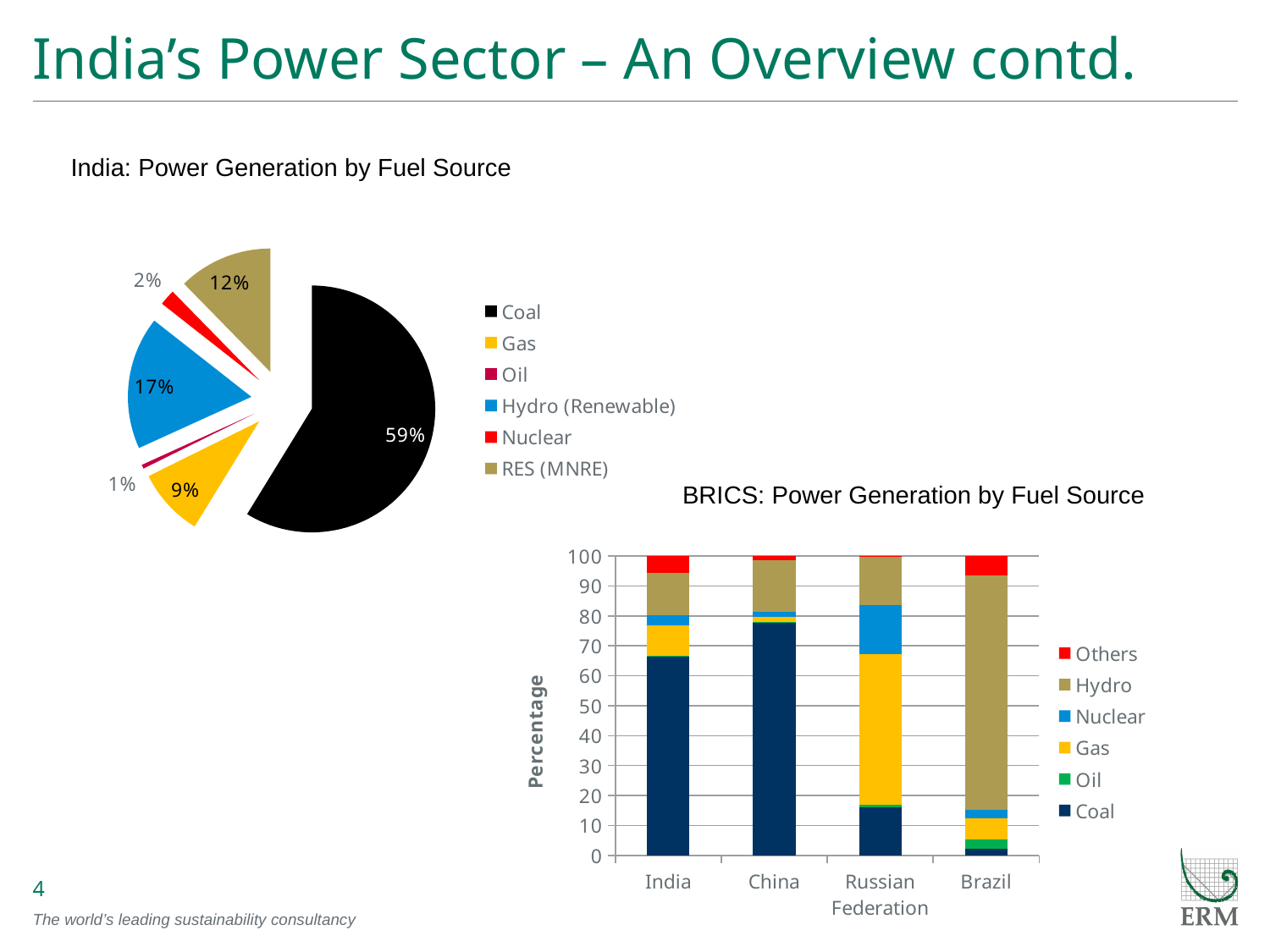
In the 'India: Power Generation by Fuel Source' pie chart, what is the difference between the Hydro (Renewable) share and the Gas share? 8% In the 'BRICS: Power Generation by Fuel Source' chart, is the Coal value for Brazil greater or less than 10? less In the 'BRICS: Power Generation by Fuel Source' chart, which country has the largest Hydro segment? Brazil In the 'India: Power Generation by Fuel Source' pie chart, which fuel source has the smallest share? Oil In the 'India: Power Generation by Fuel Source' pie chart, what share does Coal have? 59% What kind of chart is 'BRICS: Power Generation by Fuel Source'? Stacked bar chart How many countries are shown on the x axis of the 'BRICS: Power Generation by Fuel Source' chart? 4 In the 'BRICS: Power Generation by Fuel Source' chart, is the Coal value for China greater or less than 70? greater How many fuel sources does the legend of the 'India: Power Generation by Fuel Source' pie chart list? 6 In the 'India: Power Generation by Fuel Source' pie chart, what share does Hydro (Renewable) have? 17% In the 'India: Power Generation by Fuel Source' pie chart, which is larger, the Nuclear share or the Gas share? Gas In the 'India: Power Generation by Fuel Source' pie chart, what share does RES (MNRE) have? 12%